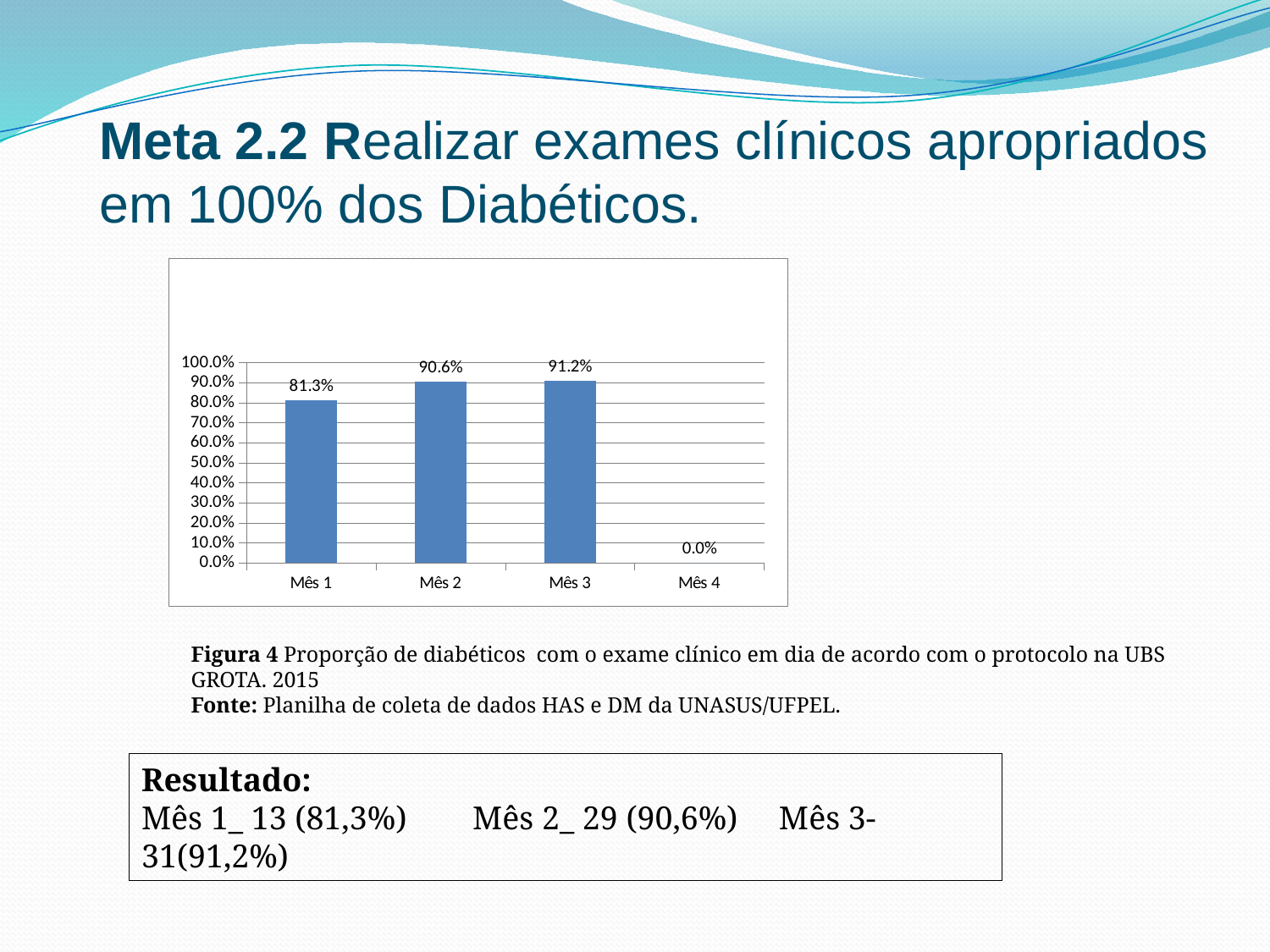
Which month has the lowest value? Mês 4 What kind of chart is shown on the slide? bar chart What is the value for Mês 1? 81.3% How many months are shown on the x axis? 4 What is the value for Mês 3? 91.2% What is the difference between the values for Mês 2 and Mês 1? 9.3% Which is larger, the value for Mês 1 or the value for Mês 2? Mês 2 Do the values rise or fall from Mês 1 to Mês 3? rise Is the value for Mês 1 greater or less than 90.0%? less What is the value for Mês 2? 90.6% Which month has the highest value? Mês 3 What is the value for Mês 4? 0.0%